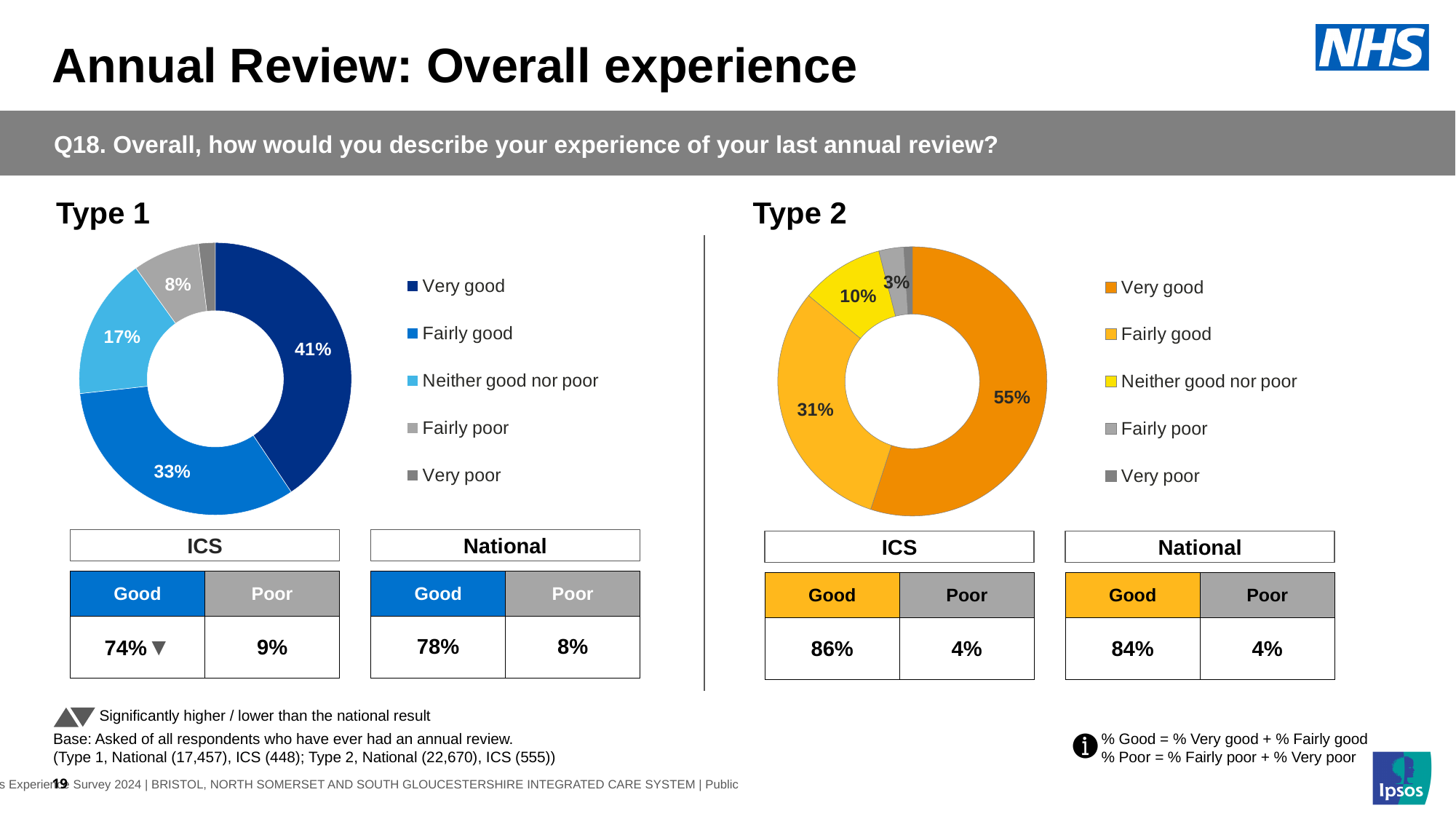
In the Type 2 chart, what percentage of respondents said 'Fairly poor'? 3% How many categories does the legend of the Type 1 chart list? 5 In the Type 1 chart, which category has the smallest share? Very poor In the Type 1 chart, what percentage of respondents said their experience was 'Very good'? 41% In the Type 2 chart, what percentage of respondents said their experience was 'Fairly good'? 31% In the Type 2 chart, which category has the largest share? Very good In the Type 2 chart, what is the difference between the 'Very good' and 'Fairly good' shares? 24 percentage points What type of chart is used for Type 1 and Type 2? Donut (pie) chart Which is larger: the 'Very good' share in the Type 1 chart or the 'Very good' share in the Type 2 chart? Type 2 In the Type 1 chart, what percentage of respondents said 'Neither good nor poor'? 17% In the Type 1 chart, what is the difference between the 'Very good' and 'Fairly good' shares? 8 percentage points In the Type 2 chart, what colour represents 'Neither good nor poor'? Yellow